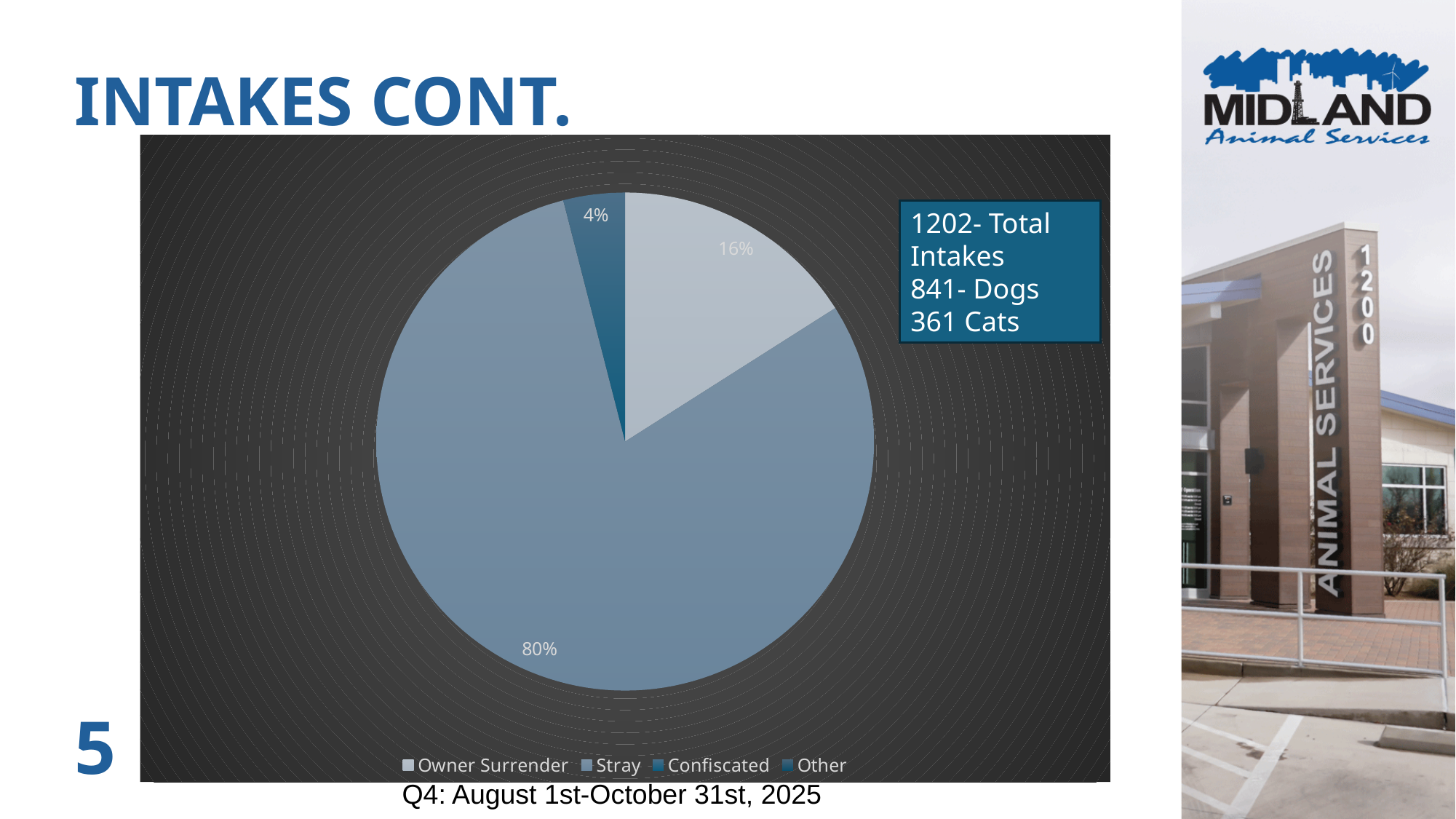
What kind of chart is shown on the slide? pie chart According to the text box on the chart, what is the total number of intakes? 1202 Which is larger, the Owner Surrender share or the Confiscated share? Owner Surrender According to the text box on the chart, how many of the intakes were dogs? 841 What percentage of intakes does the Owner Surrender slice represent? 16% What percentage of intakes does the Stray slice represent? 80% What is the difference in percentage points between the Stray share and the Owner Surrender share? 64 percentage points What percentage of intakes does the Confiscated slice represent? 4% Is the Stray share greater or less than 50%? greater How many categories does the legend list? 4 Which intake category has the largest share of the pie? Stray